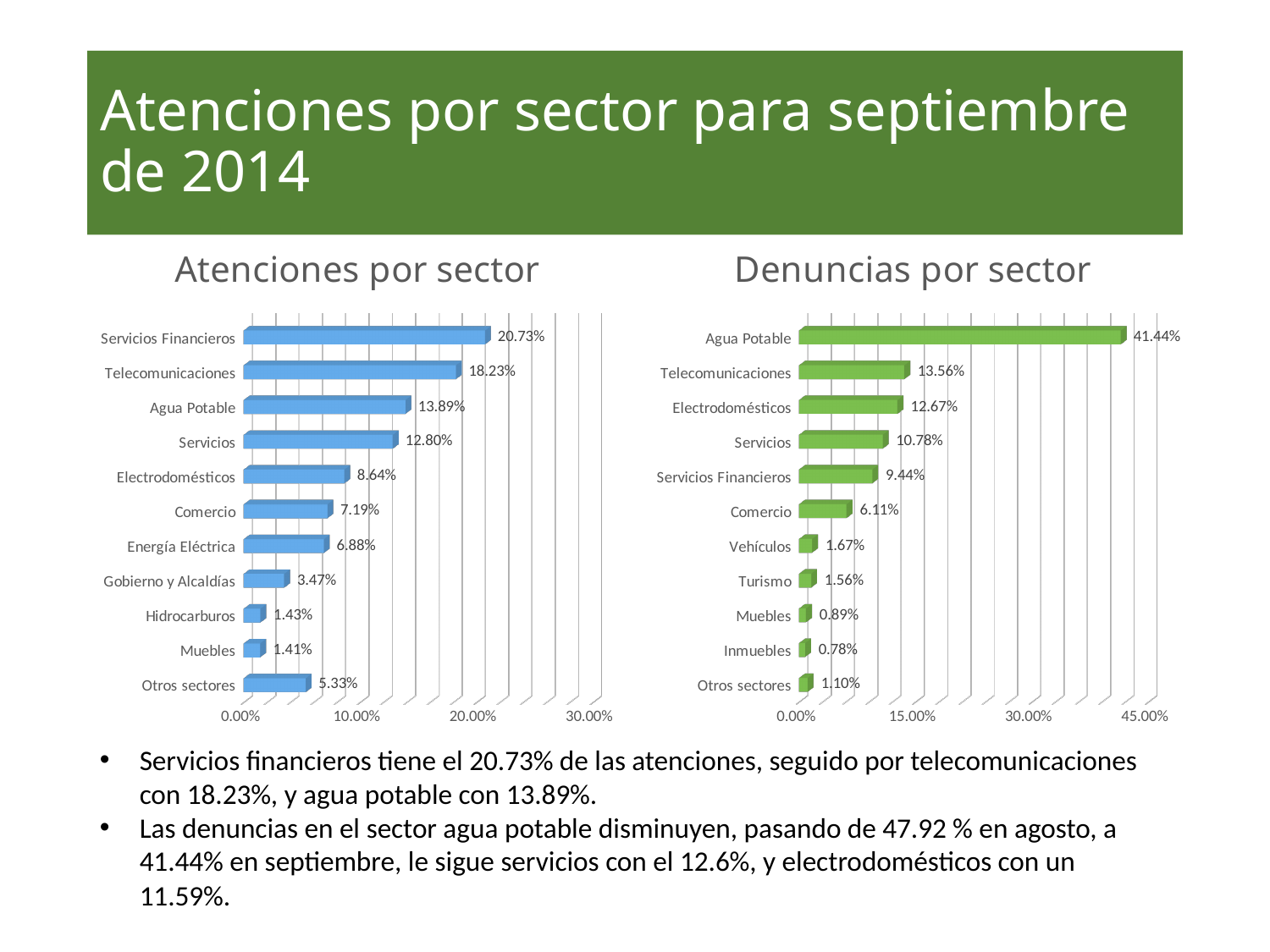
How many sectors are shown in the 'Atenciones por sector' chart? 11 In the 'Denuncias por sector' chart, what is the value for Vehículos? 1.67% In the 'Atenciones por sector' chart, what is the difference between Servicios Financieros and Telecomunicaciones? 2.50% In the 'Denuncias por sector' chart, is the value for Servicios greater or less than 15.00%? less In the 'Atenciones por sector' chart, which sector has the highest value? Servicios Financieros In the 'Atenciones por sector' chart, which is larger: Comercio or Electrodomésticos? Electrodomésticos In the 'Atenciones por sector' chart, what is the value for Servicios Financieros? 20.73% In the 'Atenciones por sector' chart, what is the value for Energía Eléctrica? 6.88% In the 'Denuncias por sector' chart, what is the difference between Agua Potable and Telecomunicaciones? 27.88% In the 'Denuncias por sector' chart, which sector has the highest value? Agua Potable What type of chart is 'Denuncias por sector'? Bar chart In the 'Denuncias por sector' chart, what is the value for Agua Potable? 41.44%